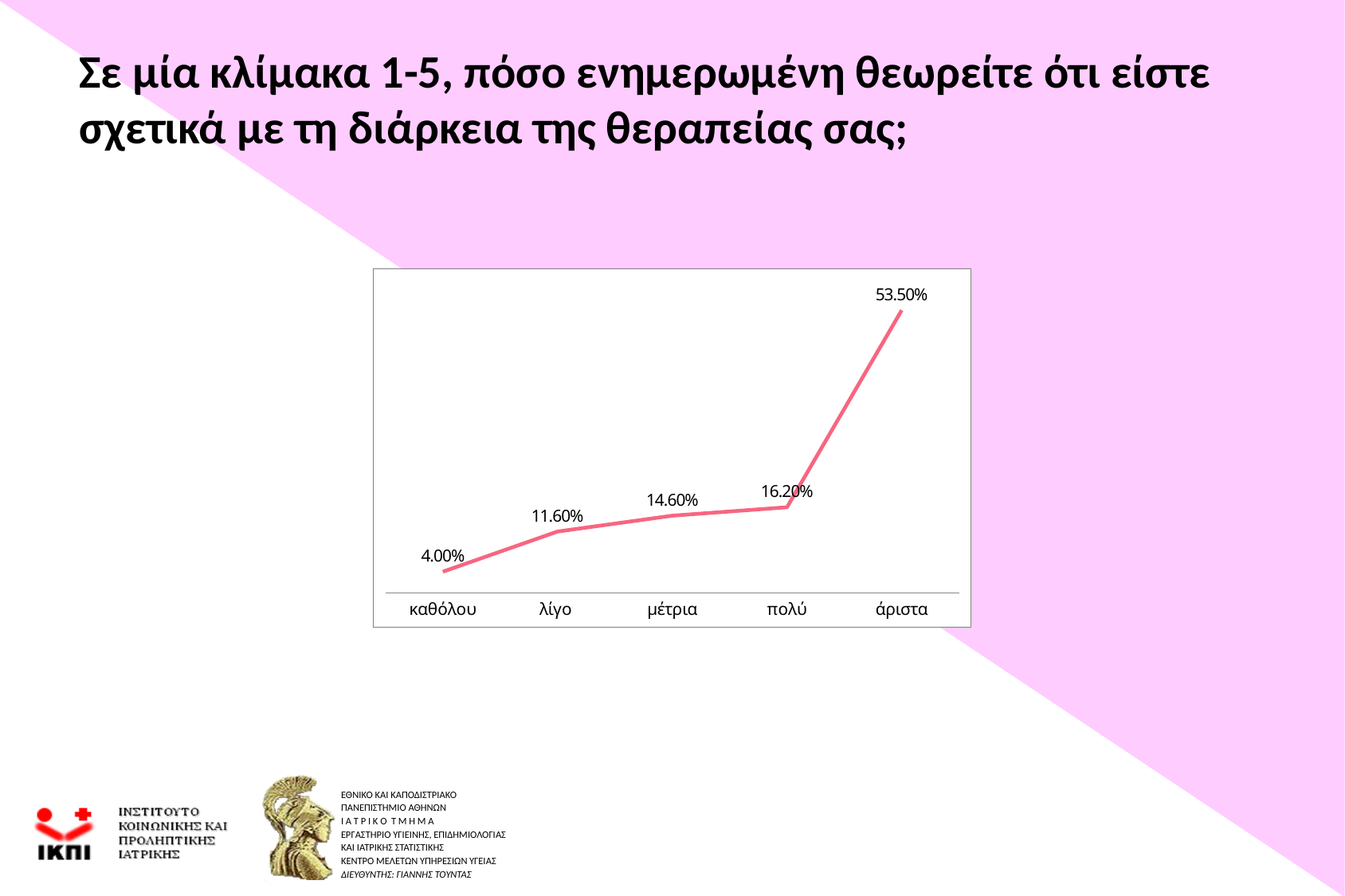
How many categories are shown on the x axis? 5 Which is larger, the value for λίγο or the value for μέτρια? μέτρια What kind of chart is shown on the slide? line chart What is the value for άριστα? 53.50% Do the values rise or fall from καθόλου to άριστα along the x axis? rise Which category has the lowest value? καθόλου What is the value for πολύ? 16.20% Which category has the highest value? άριστα What is the value for καθόλου? 4.00% What is the value for λίγο? 11.60% What is the value for μέτρια? 14.60% What is the difference between the values for άριστα and πολύ? 37.30%